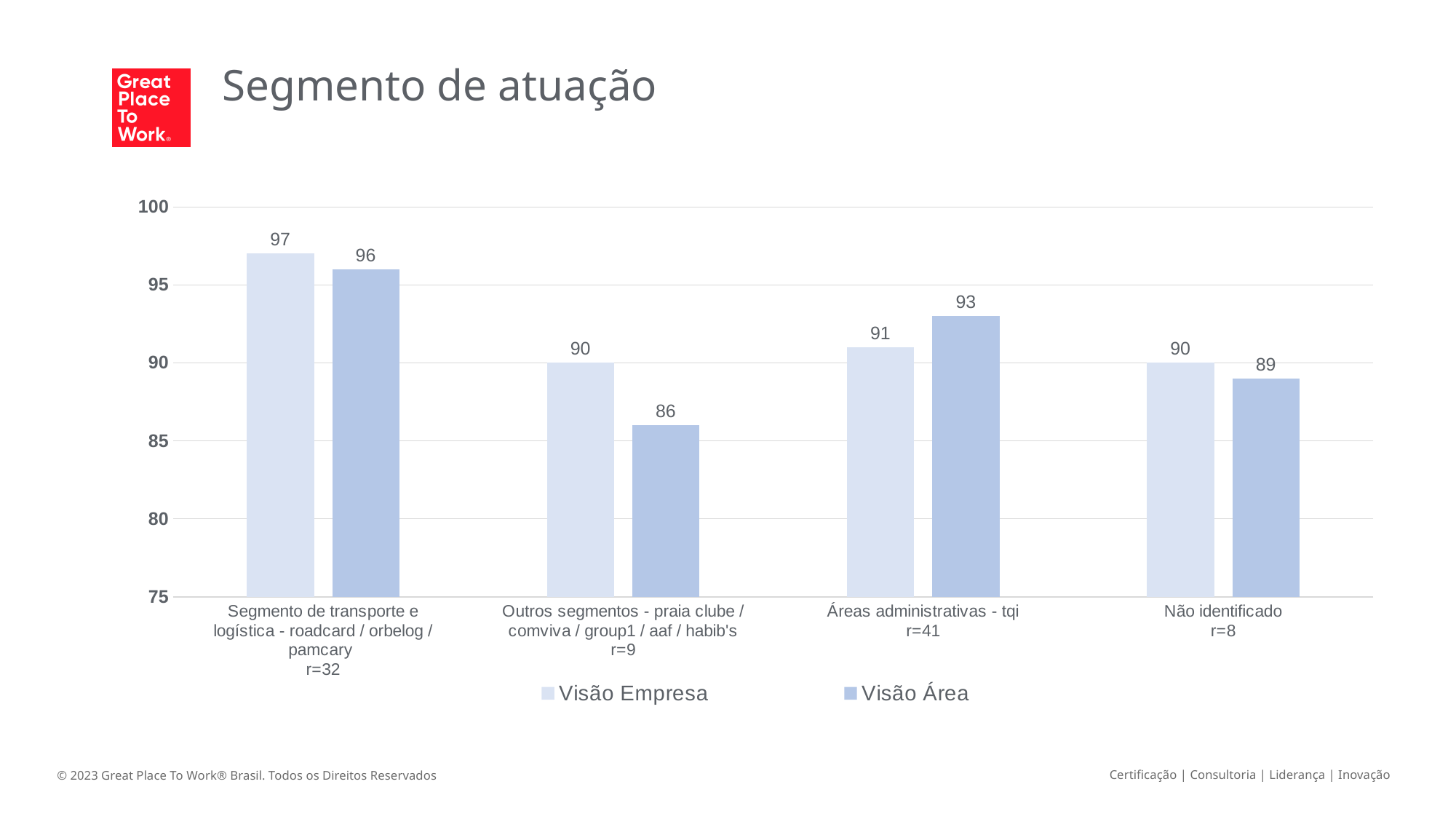
Which category has the highest Visão Área value? Segmento de transporte e logística - roadcard / orbelog / pamcary What is the Visão Empresa value for 'Segmento de transporte e logística - roadcard / orbelog / pamcary'? 97 What is the Visão Área value for 'Outros segmentos - praia clube / comviva / group1 / aaf / habib's'? 86 How many categories are shown on the x axis? 4 What kind of chart is shown on the slide? bar chart What is the Visão Empresa value for 'Não identificado'? 90 For 'Áreas administrativas - tqi', which is larger: Visão Empresa or Visão Área? Visão Área Is the Visão Área value for 'Não identificado' greater or less than 90? less Which category has the lowest Visão Área value? Outros segmentos - praia clube / comviva / group1 / aaf / habib's How many series does the legend list? 2 What is the difference between the Visão Empresa and Visão Área values for 'Outros segmentos - praia clube / comviva / group1 / aaf / habib's'? 4 What is the Visão Área value for 'Áreas administrativas - tqi'? 93